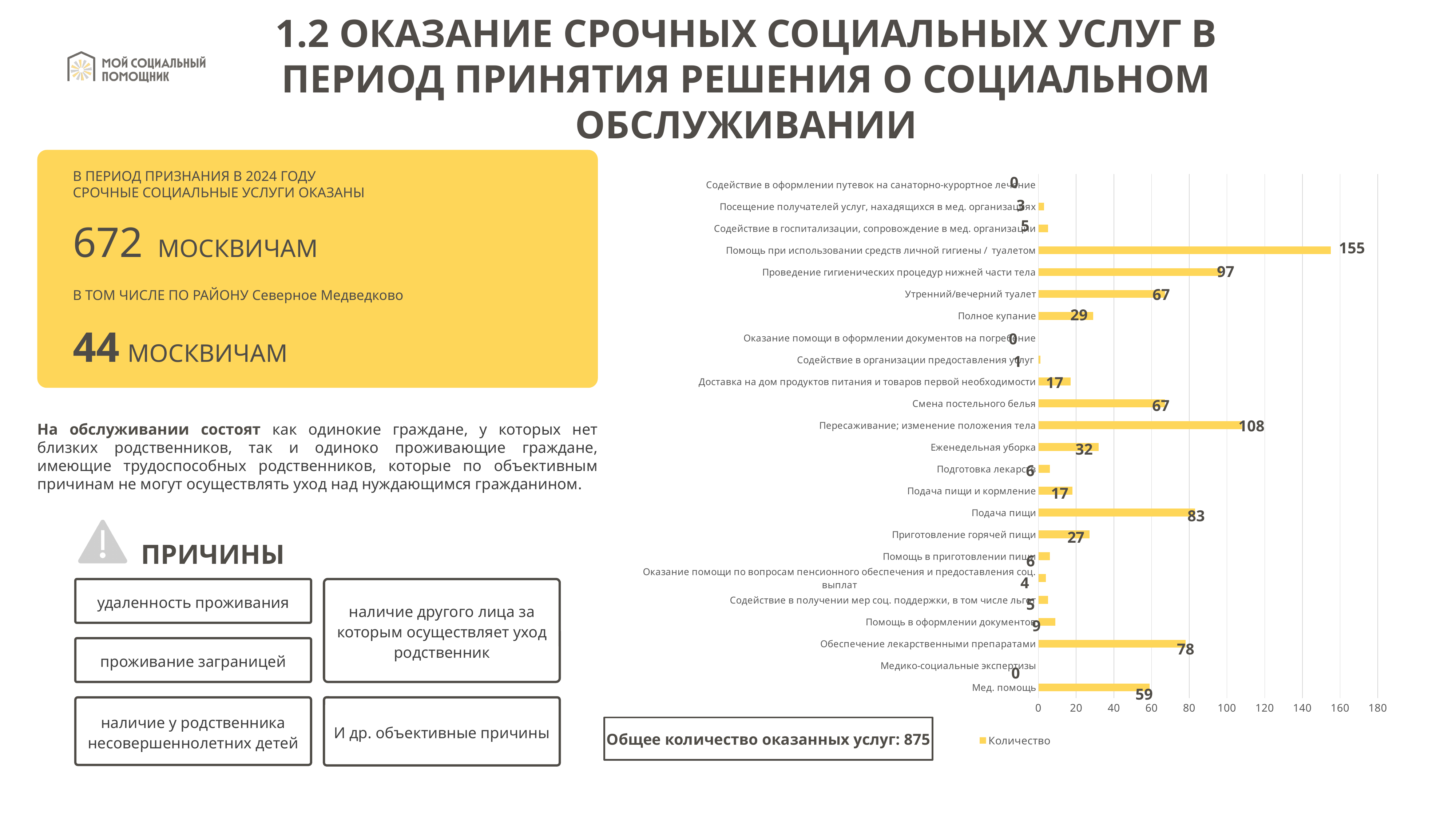
What value is shown for Мед. помощь? 59 What is the difference between the values for Пересаживание; изменение положения тела and Подача пищи? 25 What kind of chart is shown on the slide? bar chart What is the difference between the values for Помощь при использовании средств личной гигиены / туалетом and Проведение гигиенических процедур нижней части тела? 58 What value is shown for Помощь при использовании средств личной гигиены / туалетом? 155 How many categories are shown in the chart? 24 What value is shown for Пересаживание; изменение положения тела? 108 Is the value for Проведение гигиенических процедур нижней части тела greater or less than 80? greater What value is shown for Обеспечение лекарственными препаратами? 78 Which category has the highest value in the chart? Помощь при использовании средств личной гигиены / туалетом Which is larger: the value for Еженедельная уборка or the value for Полное купание? Еженедельная уборка How many series does the chart legend list? 1